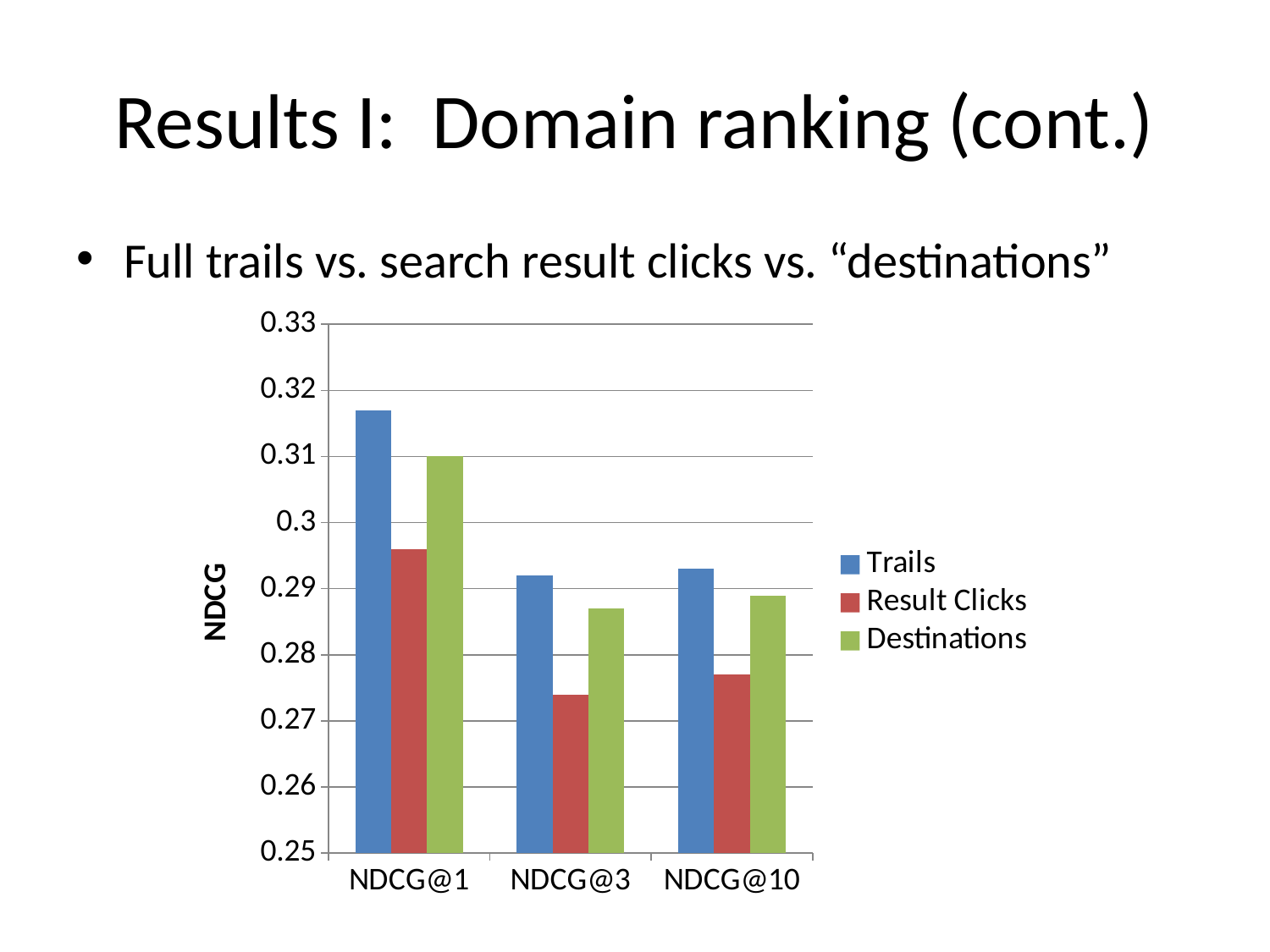
Which series is shown in green in the legend? Destinations For the Trails series, which category has the highest value? NDCG@1 Is the value for Trails at NDCG@1 greater or less than 0.31? greater What is the label on the vertical axis? NDCG Which series has the highest value at NDCG@1? Trails How many series does the legend list? 3 Does the Trails series rise or fall from NDCG@1 to NDCG@3? fall Which series has the lowest value at NDCG@3? Result Clicks Is the value for Result Clicks at NDCG@3 greater or less than 0.28? less How many categories are shown on the x axis? 3 What kind of chart is shown on the slide? bar chart Which is larger at NDCG@3: Destinations or Result Clicks? Destinations